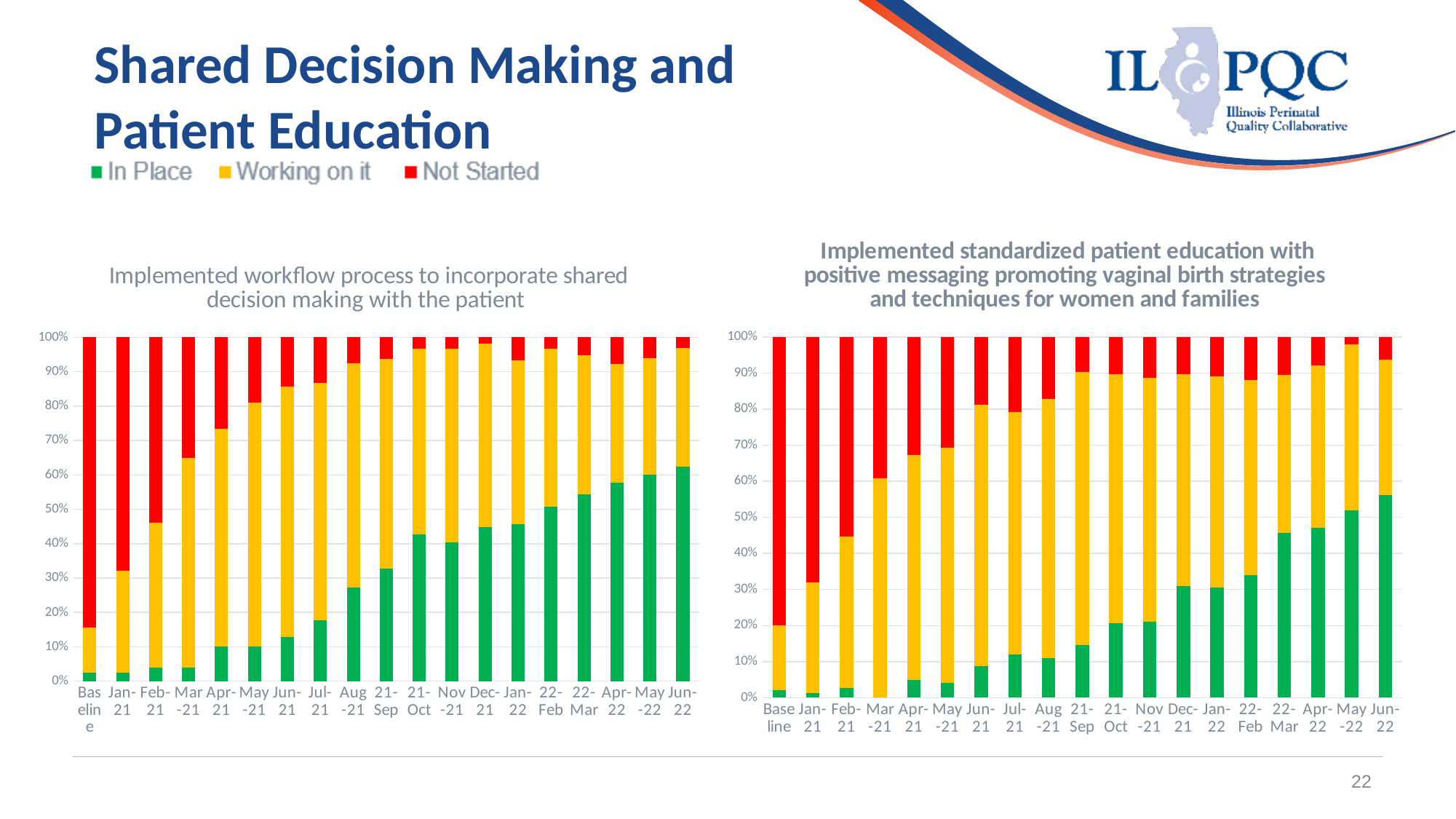
How many series does the legend at the top of the slide list? 3 In the right chart, is the 'In Place' value for Baseline greater or less than 10%? less In the left chart, does the 'In Place' share generally rise or fall from Baseline to Jun-22? Rise In the right chart, is the 'In Place' value for Jun-22 greater or less than 50%? greater In the right chart, which period has the highest 'In Place' value? Jun-22 In the right chart, does the 'Not Started' share generally rise or fall from Baseline to Jun-22? Fall In the left chart, is the 'In Place' value for Jan-21 greater or less than 10%? less What kind of chart is the left chart, 'Implemented workflow process to incorporate shared decision making with the patient'? Stacked bar chart How many time-period categories are shown on the x axis of the left chart? 19 Which colour represents 'Not Started' in the legend? Red How many time-period categories are shown on the x axis of the right chart, 'Implemented standardized patient education...'? 19